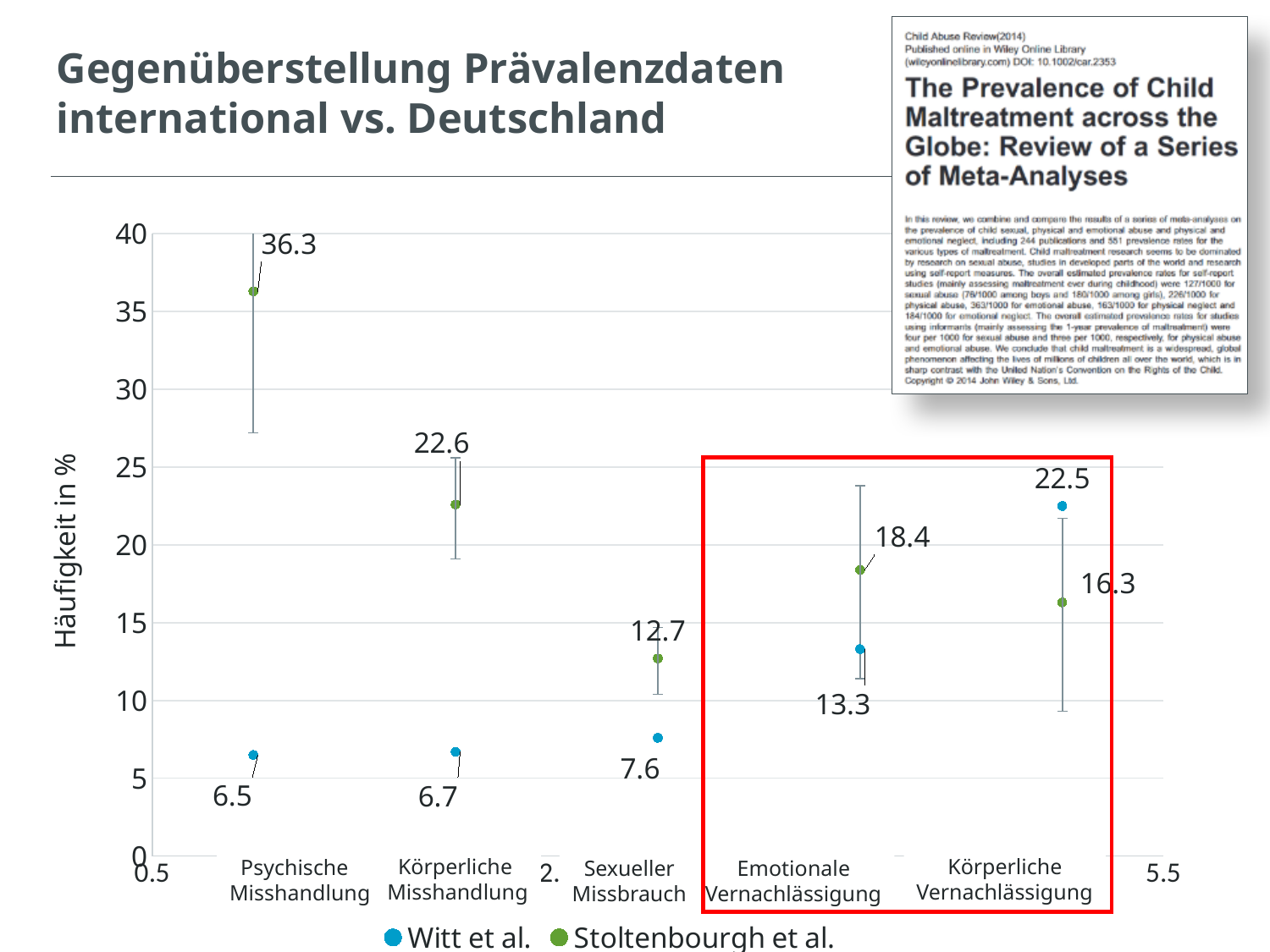
What is the label of the y axis? Häufigkeit in % Which category has the highest value for Stoltenbourgh et al.? Psychische Misshandlung What is the value for Witt et al. for Sexueller Missbrauch? 7.6 Which two categories are enclosed by the red box? Emotionale Vernachlässigung and Körperliche Vernachlässigung What is the value for Stoltenbourgh et al. for Emotionale Vernachlässigung? 18.4 For Körperliche Vernachlässigung, which series has the larger value, Witt et al. or Stoltenbourgh et al.? Witt et al. What is the value for Stoltenbourgh et al. for Psychische Misshandlung? 36.3 What is the difference between the Stoltenbourgh et al. and Witt et al. values for Psychische Misshandlung? 29.8 How many series does the legend list? 2 How many categories are shown on the x axis? 5 Which category has the lowest value for Witt et al.? Psychische Misshandlung What is the value for Witt et al. for Körperliche Vernachlässigung? 22.5